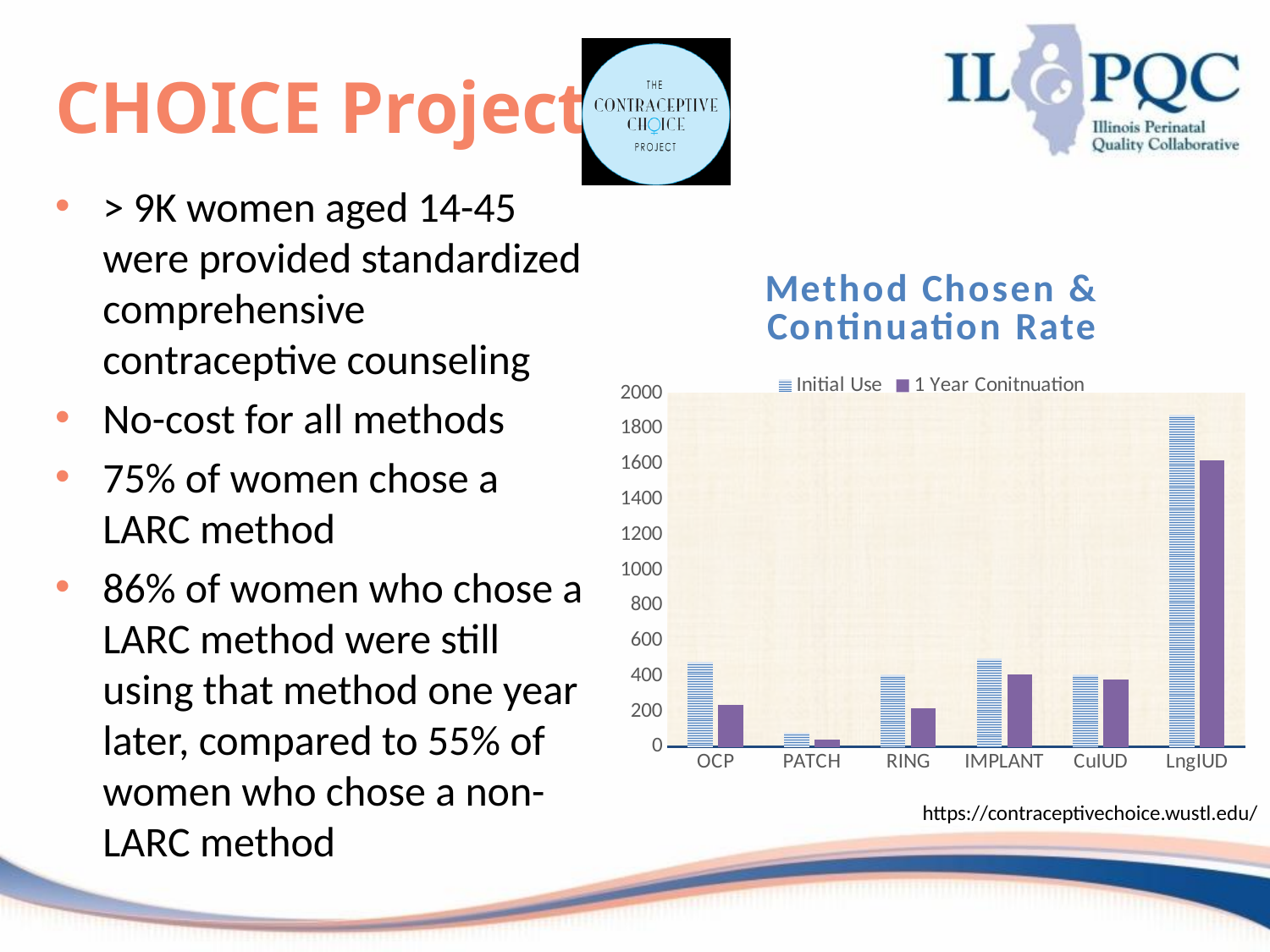
Which method has the highest Initial Use value in the chart? LngIUD Which method has the lowest 1 Year Conitnuation value in the chart? PATCH What is the title of the chart? Method Chosen & Continuation Rate Is the Initial Use value for LngIUD greater or less than 1600? greater Is the Initial Use value for PATCH greater or less than 200? less How many series does the chart's legend list? 2 Which series in the chart is drawn with solid purple bars? 1 Year Conitnuation What kind of chart is shown on the slide? bar chart How many contraceptive methods (categories) are shown on the x axis of the chart? 6 Which method has a higher Initial Use value, IMPLANT or PATCH? IMPLANT Is the 1 Year Conitnuation value for LngIUD greater or less than 1400? greater For OCP, which is larger: the Initial Use value or the 1 Year Conitnuation value? Initial Use